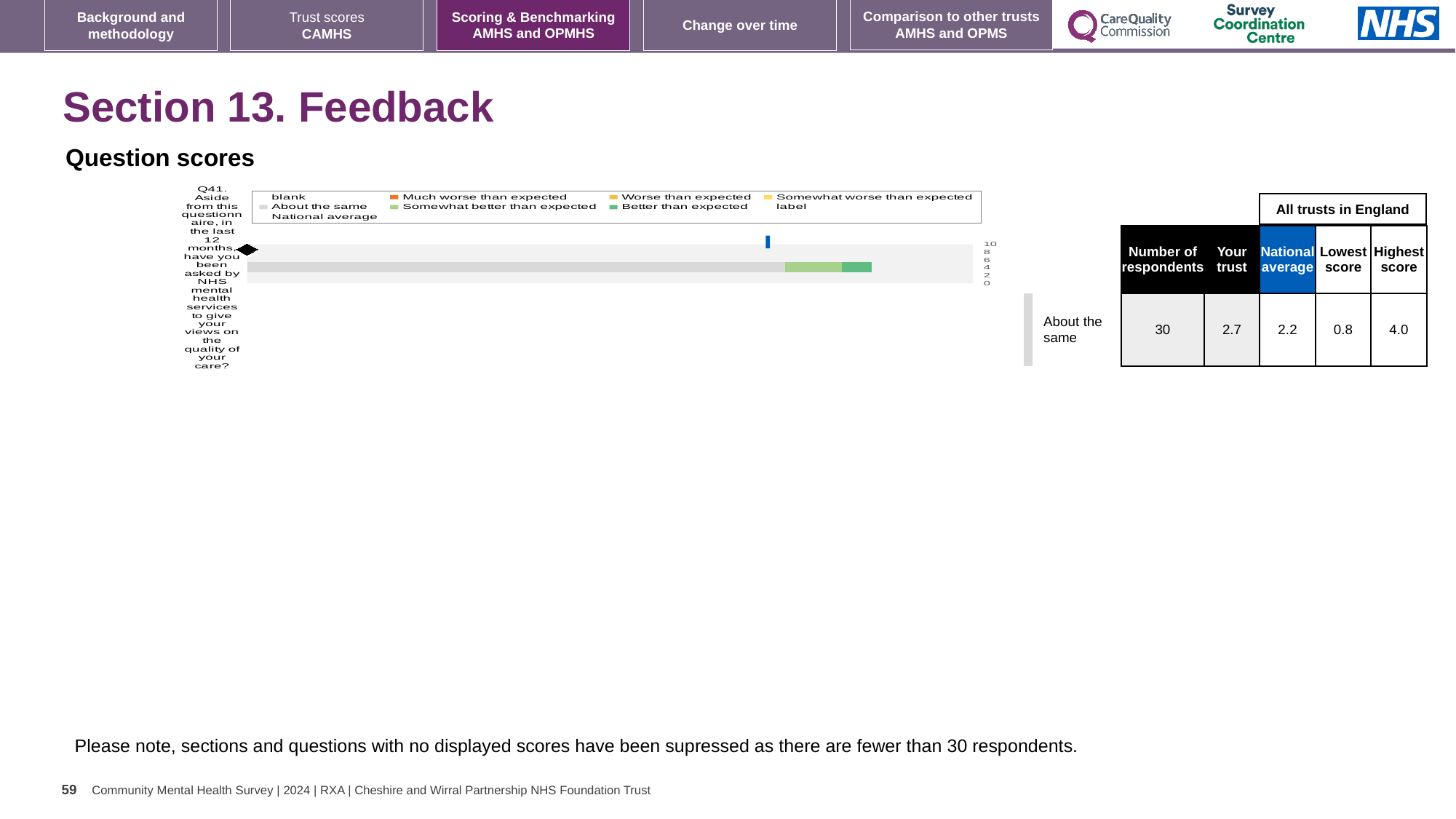
How many survey questions are plotted in the chart on the slide? 1 Which is larger for Q41, the 'Your trust' score or the national average? Your trust What is the difference between the highest and lowest scores for Q41 across all trusts in England? 3.2 What is the highest score among all trusts in England for Q41? 4.0 What is the national average score for Q41? 2.2 Which question number is plotted in the chart? Q41 What kind of chart is shown for Q41 on the slide? bar chart What is the lowest score among all trusts in England for Q41? 0.8 What is the 'Your trust' score for Q41? 2.7 What is the difference between the 'Your trust' score and the national average for Q41? 0.5 What colour does the legend use for 'Much worse than expected'? orange How many respondents answered Q41? 30